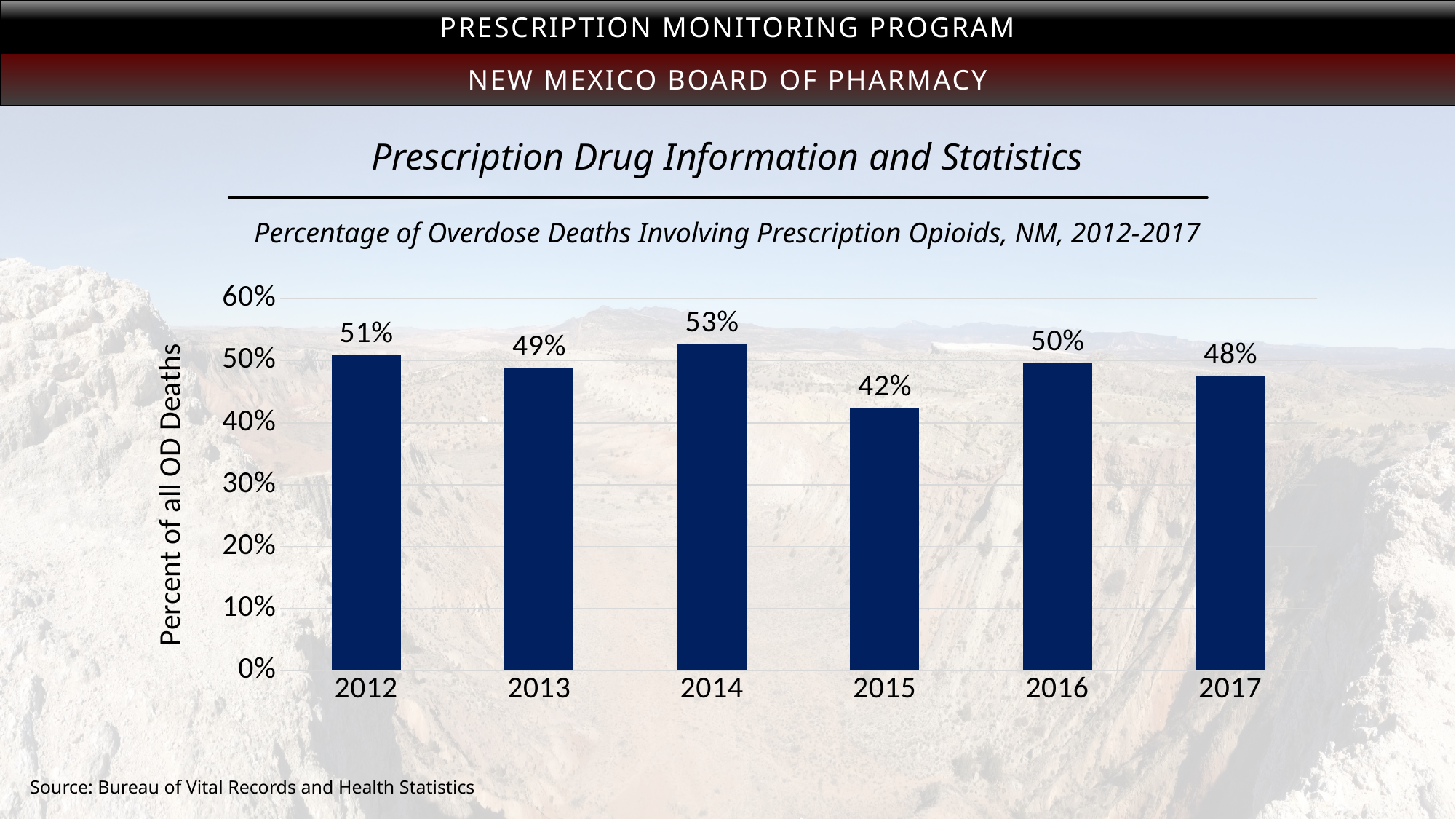
What is the difference between the 2014 and 2015 values? 11% How many years are shown on the x axis? 6 Is the value for 2015 greater or less than 50%? less What is the difference between the 2012 and 2017 values? 3% Which year has the highest percentage of overdose deaths involving prescription opioids? 2014 What is the value shown for 2015? 42% What percentage is shown for 2017? 48% What percentage of overdose deaths involved prescription opioids in 2014? 53% Which year has a larger value, 2013 or 2016? 2016 Which year has the lowest percentage? 2015 What kind of chart is shown on the slide? Bar chart What is the label on the vertical axis of the chart? Percent of all OD Deaths